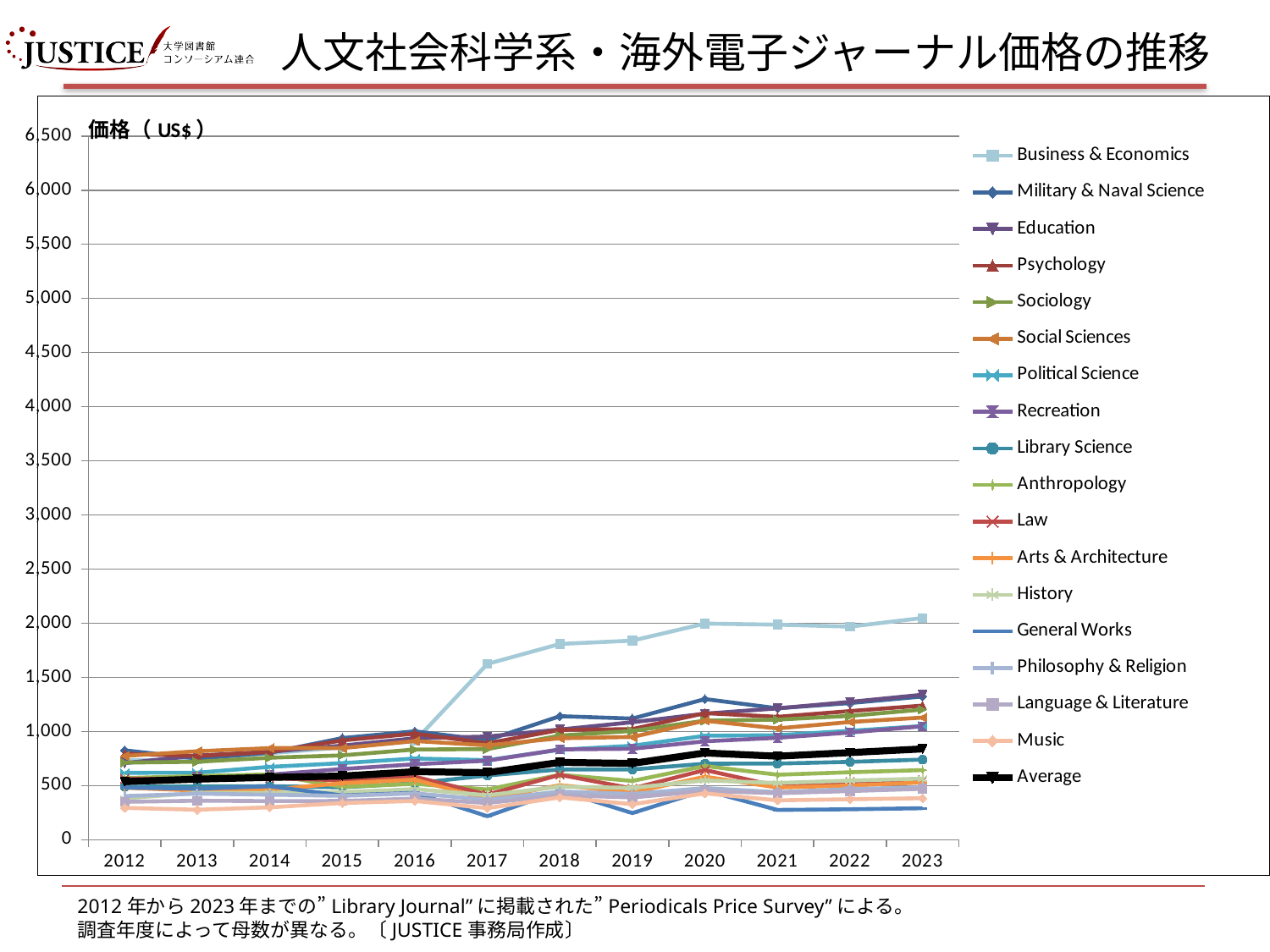
Is the value for Business & Economics in 2012 greater or less than 1,000? less Which series has the highest value in 2023? Business & Economics How many years are plotted along the x axis? 12 Does the Business & Economics line generally rise or fall from 2012 to 2023? rise What kind of chart is shown on the slide? line chart What label is shown for the y axis of the chart? 価格（US$） Is the value for Business & Economics in 2023 greater or less than 1,500? greater How many series does the legend list? 18 In 2020, which is larger: the value for Business & Economics or the value for Average? Business & Economics Which series has the lowest value in 2023? General Works Is the value for Average in 2023 greater or less than 1,000? less What is the highest tick value shown on the y axis? 6,500